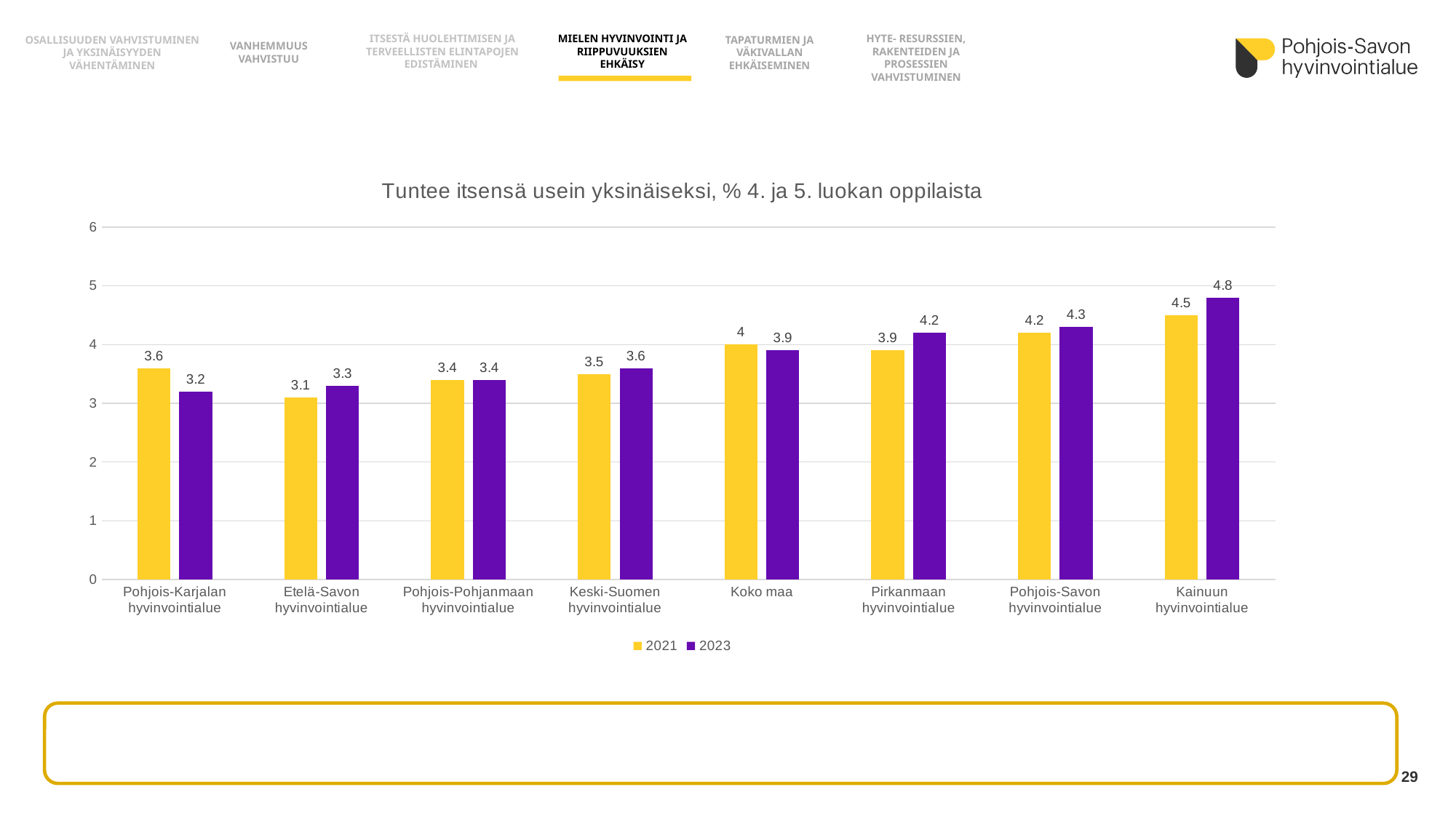
Which category has the lowest 2021 value? Etelä-Savon hyvinvointialue What is the 2021 value for Etelä-Savon hyvinvointialue? 3.1 What is the difference between the 2023 and 2021 values for Pohjois-Karjalan hyvinvointialue? 0.4 What is the title of the chart? Tuntee itsensä usein yksinäiseksi, % 4. ja 5. luokan oppilaista How many series does the legend list? 2 What is the 2023 value for Kainuun hyvinvointialue? 4.8 Which is larger for Pirkanmaan hyvinvointialue, the 2021 value or the 2023 value? 2023 How many categories are shown on the x axis? 8 Is the 2023 value for Pohjois-Savon hyvinvointialue greater or less than 4? greater What is the 2021 value for Koko maa? 4 What kind of chart is shown on the slide? Bar chart Which category has the highest 2023 value? Kainuun hyvinvointialue